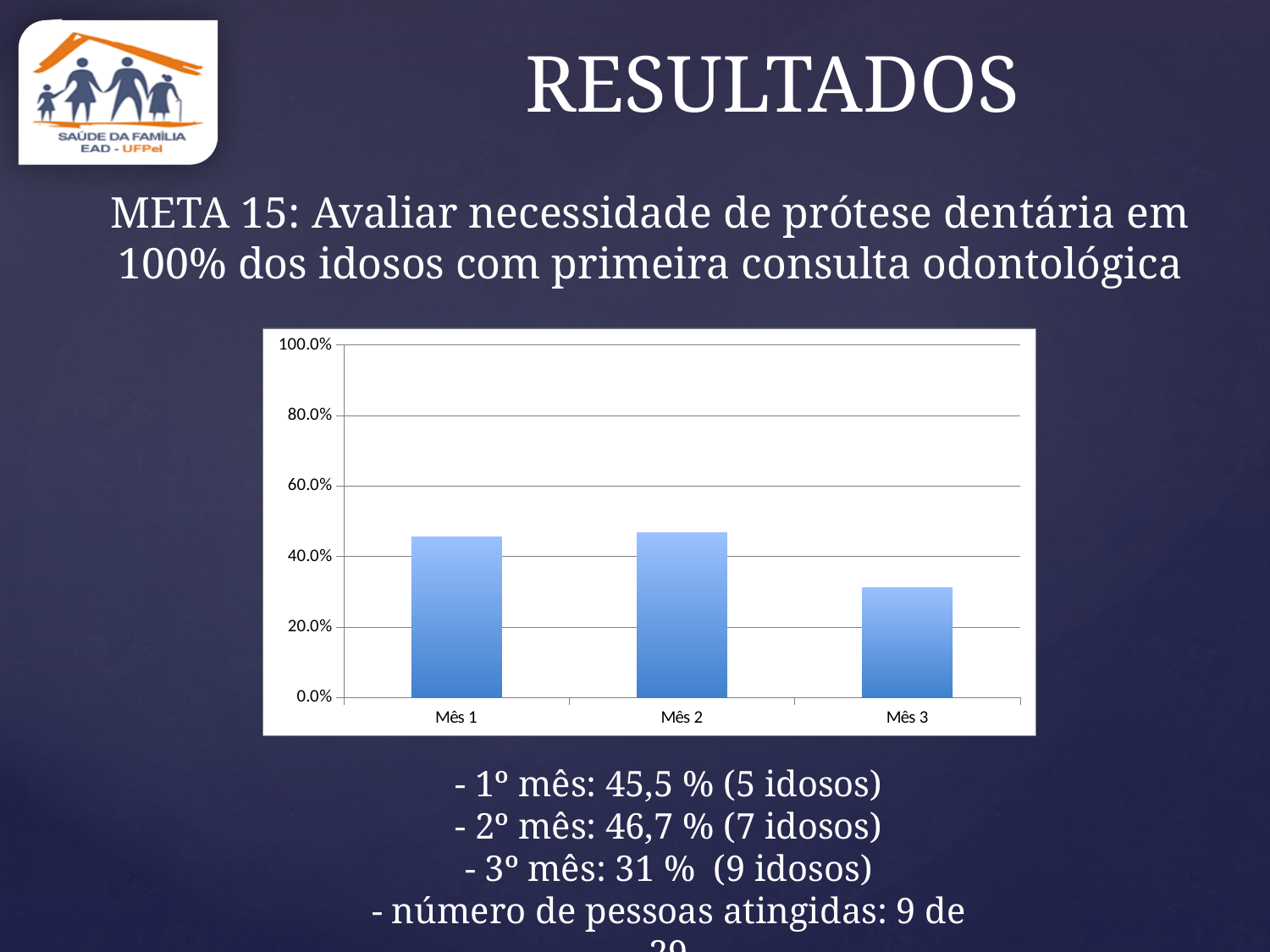
According to the text below the chart, what percentage was reached in the 1º mês? 45,5 % Is the bar for Mês 1 larger or smaller than the bar for Mês 3? larger What kind of chart is shown on the slide? bar chart Which month has the lowest bar on the chart? Mês 3 How many categories (months) are plotted on the chart? 3 Is the value for Mês 3 greater or less than 20%? greater What is the highest value shown on the chart's vertical axis? 100.0% According to the text below the chart, what percentage was reached in the 3º mês? 31 % Is the value for Mês 3 greater or less than 40%? less Is the value for Mês 1 greater or less than 40%? greater Do the values rise or fall from Mês 2 to Mês 3? fall